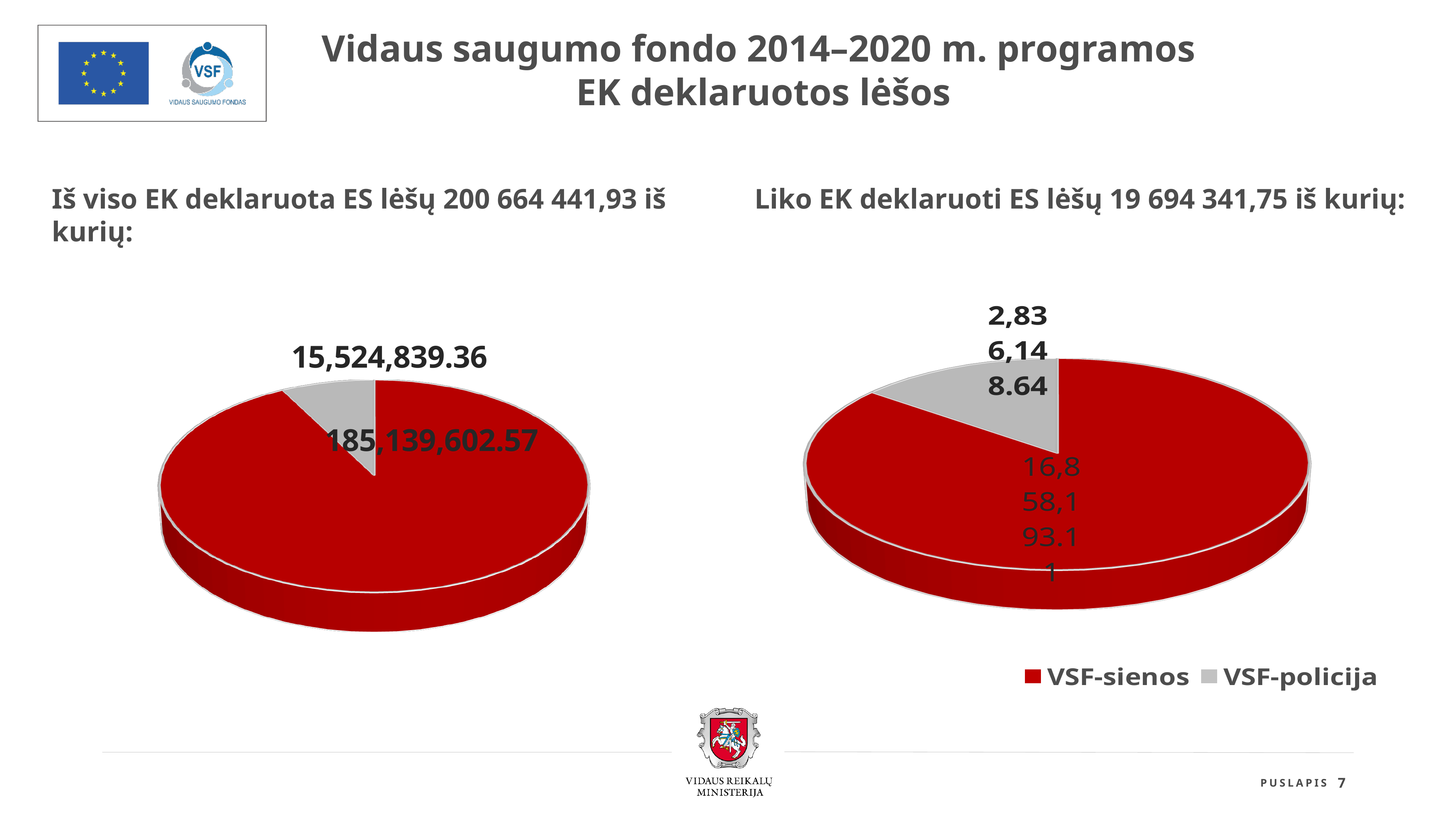
In the right pie chart (Liko EK deklaruoti), which category has the largest slice? VSF-sienos In the left pie chart (Iš viso EK deklaruota), what value is shown for the grey slice? 15,524,839.36 In the right pie chart (Liko EK deklaruoti), which category has the smallest slice? VSF-policija In the right pie chart (Liko EK deklaruoti), what value is shown for VSF-policija? 2,836,148.64 In the left pie chart (Iš viso EK deklaruota), which slice is larger, the red one or the grey one? The red one In the left pie chart (Iš viso EK deklaruota), what is the difference between the red slice value and the grey slice value? 169,614,763.21 How many entries does the legend of the right pie chart list? 2 In the left pie chart (Iš viso EK deklaruota), what value is shown for the red slice? 185,139,602.57 In the right pie chart (Liko EK deklaruoti), what value is shown for VSF-sienos? 16,858,193.11 In the right pie chart (Liko EK deklaruoti), what is the difference between the VSF-sienos and VSF-policija values? 14,022,044.47 What kind of chart is used on the left side of the slide? Pie chart How many slices does the right pie chart (Liko EK deklaruoti) have? 2